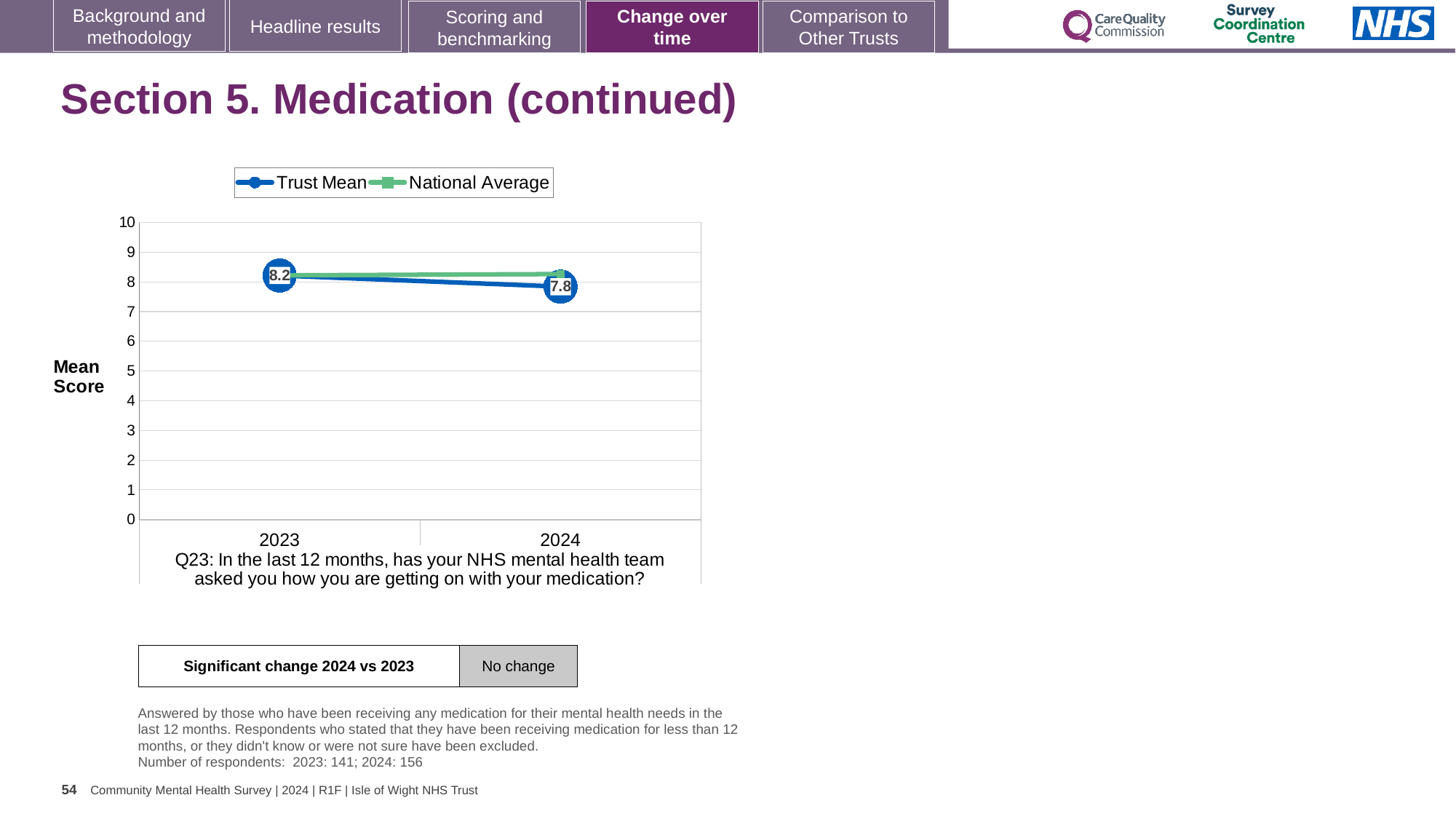
In which year is the Trust Mean highest? 2023 Which is larger, the Trust Mean for 2023 or for 2024? 2023 How many series does the legend list? 2 What is the Trust Mean value for 2024? 7.8 What is the label on the y axis of the chart? Mean Score What kind of chart is shown on the slide? line chart Does the Trust Mean rise or fall from 2023 to 2024? fall What is the Trust Mean value for 2023? 8.2 By how much did the Trust Mean change from 2023 to 2024? 0.4 Is the Trust Mean value for 2024 greater or less than 9? less How many years are plotted on the x axis? 2 Is the National Average value for 2024 greater or less than 7? greater